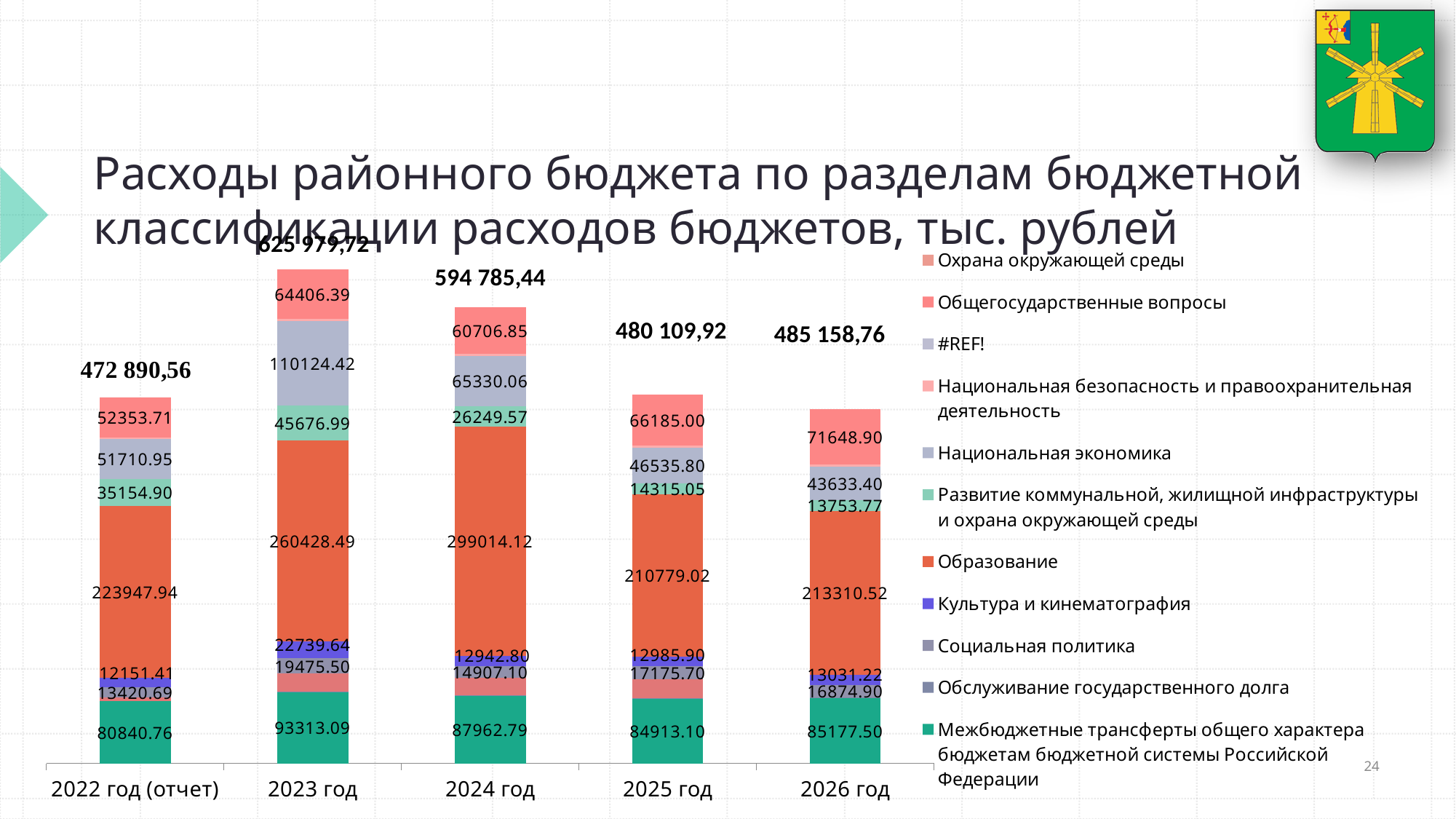
In which year is the Образование segment the largest? 2024 год What is the difference between the totals for 2023 год and 2024 год? 31 194,28 Which year has the highest total expenditure? 2023 год What is the value of the Образование segment for 2024 год? 299014.12 What is the total for 2024 год shown above the bar? 594 785,44 How many series does the legend list? 11 What kind of chart is shown on the slide? Stacked bar chart What is the value of the Межбюджетные трансферты общего характера бюджетам бюджетной системы Российской Федерации segment for 2023 год? 93313.09 What is the title of the chart? Расходы районного бюджета по разделам бюджетной классификации расходов бюджетов, тыс. рублей Which year has the lowest total expenditure? 2022 год (отчет) Which is larger, the Образование value for 2023 год or for 2024 год? 2024 год How many years (categories) are shown on the x axis? 5